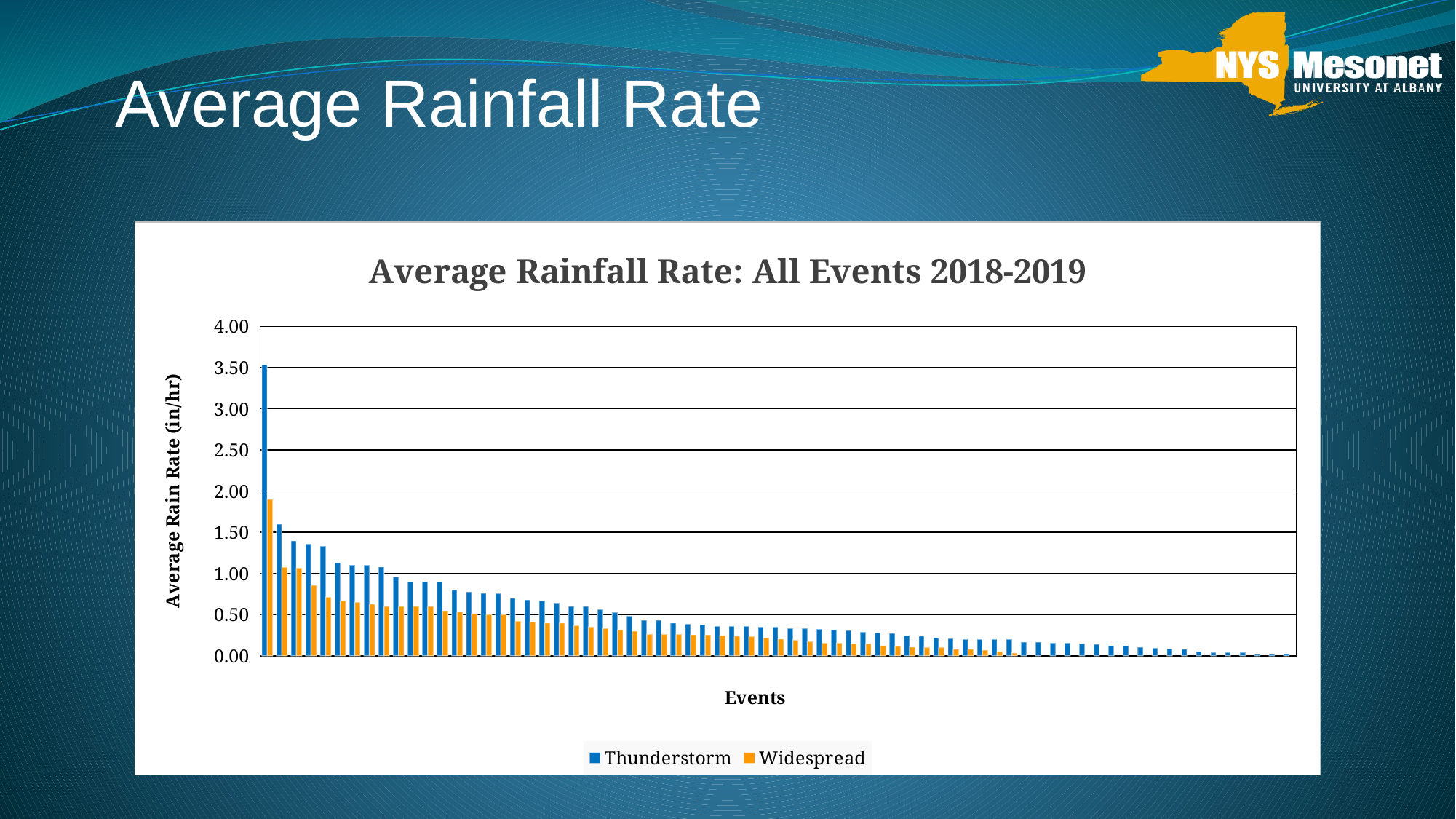
What kind of chart is shown on the slide? bar chart Is the second Thunderstorm bar from the left greater or less than 1.50? greater What is the title of the chart? Average Rainfall Rate: All Events 2018-2019 Is the tallest Widespread bar greater or less than 2.00? less How many series does the legend list? 2 Is the tallest Widespread bar greater or less than 1.50? greater Which series contains the tallest bar on the chart? Thunderstorm Do the bar values rise or fall from left to right along the x axis? fall What are the two series named in the legend? Thunderstorm and Widespread For the leftmost event, which is larger: the Thunderstorm bar or the Widespread bar? Thunderstorm